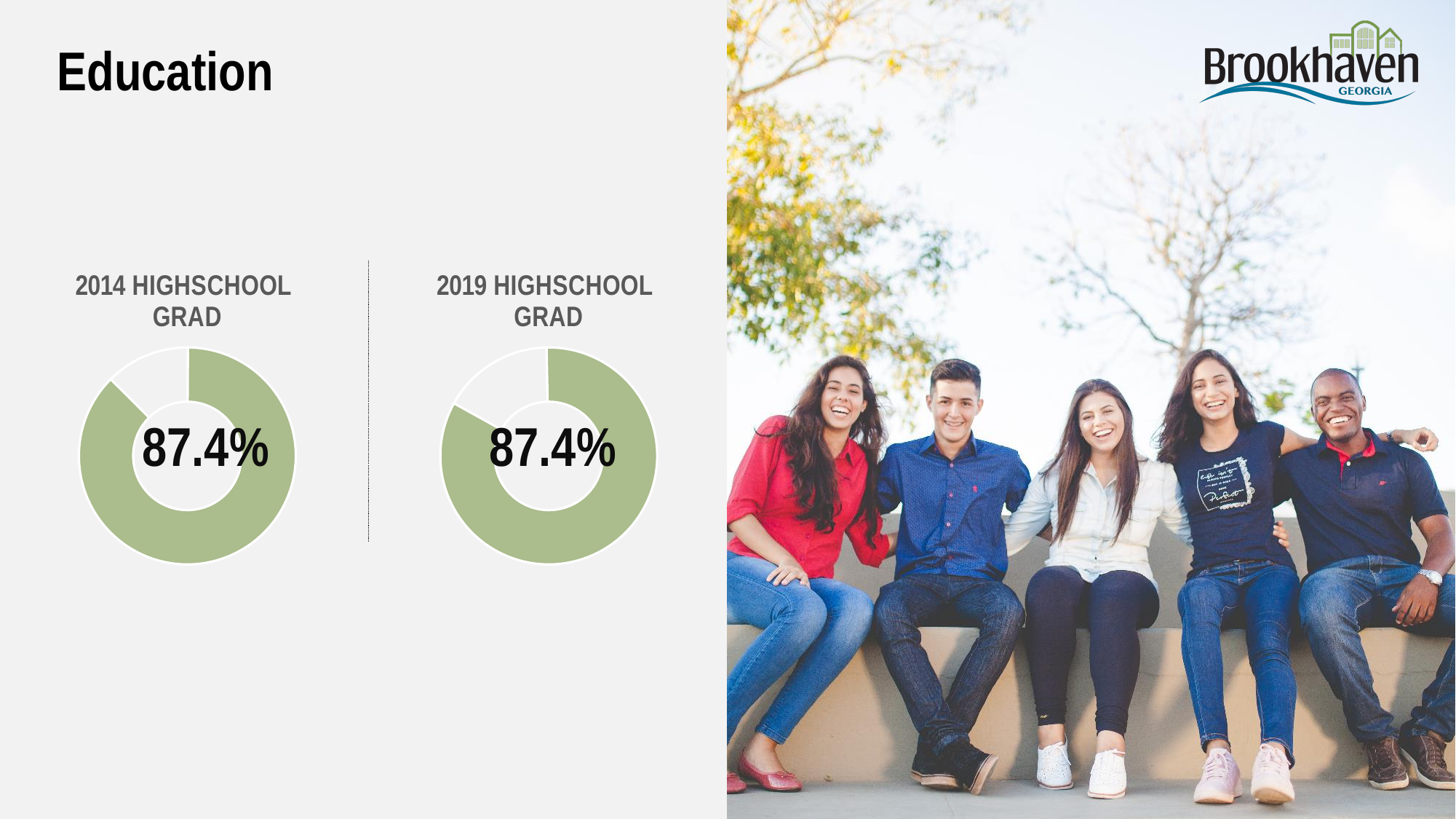
What colour is the filled portion of the donut charts? Green How many charts are shown on the slide? 2 What is the difference between the 2019 HIGHSCHOOL GRAD value and the 2014 HIGHSCHOOL GRAD value? 0 How many slices does the 2019 HIGHSCHOOL GRAD donut chart have? 2 Is the high school graduation rate for 2019 larger, smaller, or the same as for 2014? The same What kind of chart is the 2019 HIGHSCHOOL GRAD chart? Donut (pie) chart What is the title of the chart on the left? 2014 HIGHSCHOOL GRAD What kind of chart is the 2014 HIGHSCHOOL GRAD chart? Donut (pie) chart What value is shown in the centre of the 2014 HIGHSCHOOL GRAD chart? 87.4% What value is shown in the centre of the 2019 HIGHSCHOOL GRAD chart? 87.4% In the 2014 HIGHSCHOOL GRAD chart, what share of the ring is filled by the green slice? 87.4%